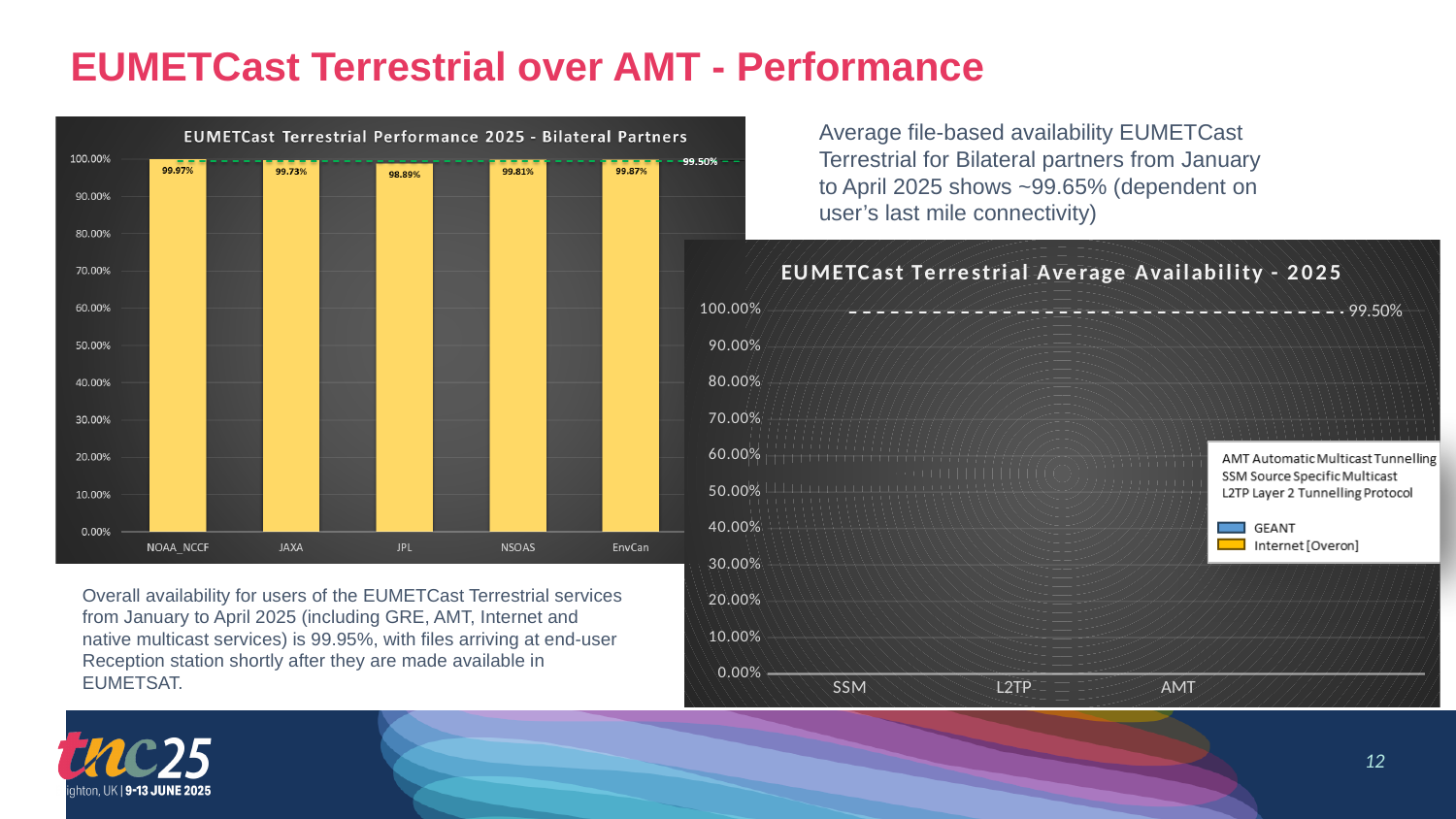
In the 'EUMETCast Terrestrial Average Availability - 2025' chart, how many series does the legend list? 2 In the 'EUMETCast Terrestrial Performance 2025 - Bilateral Partners' chart, how many partners are shown on the x axis? 5 In the 'EUMETCast Terrestrial Performance 2025 - Bilateral Partners' chart, what value is marked by the dashed reference line? 99.50% What kind of chart is the 'EUMETCast Terrestrial Performance 2025 - Bilateral Partners' chart? Bar chart In the 'EUMETCast Terrestrial Performance 2025 - Bilateral Partners' chart, what is the value for NSOAS? 99.81% In the 'EUMETCast Terrestrial Performance 2025 - Bilateral Partners' chart, which is larger, the value for JAXA or the value for EnvCan? EnvCan In the 'EUMETCast Terrestrial Average Availability - 2025' chart, how many categories are shown on the x axis? 3 In the 'EUMETCast Terrestrial Performance 2025 - Bilateral Partners' chart, what is the value for NOAA_NCCF? 99.97% In the 'EUMETCast Terrestrial Performance 2025 - Bilateral Partners' chart, what is the value for JPL? 98.89% In the 'EUMETCast Terrestrial Performance 2025 - Bilateral Partners' chart, what is the difference between the values for NOAA_NCCF and JPL? 1.08% In the 'EUMETCast Terrestrial Performance 2025 - Bilateral Partners' chart, which partner has the lowest value? JPL In the 'EUMETCast Terrestrial Performance 2025 - Bilateral Partners' chart, which partner has the highest value? NOAA_NCCF